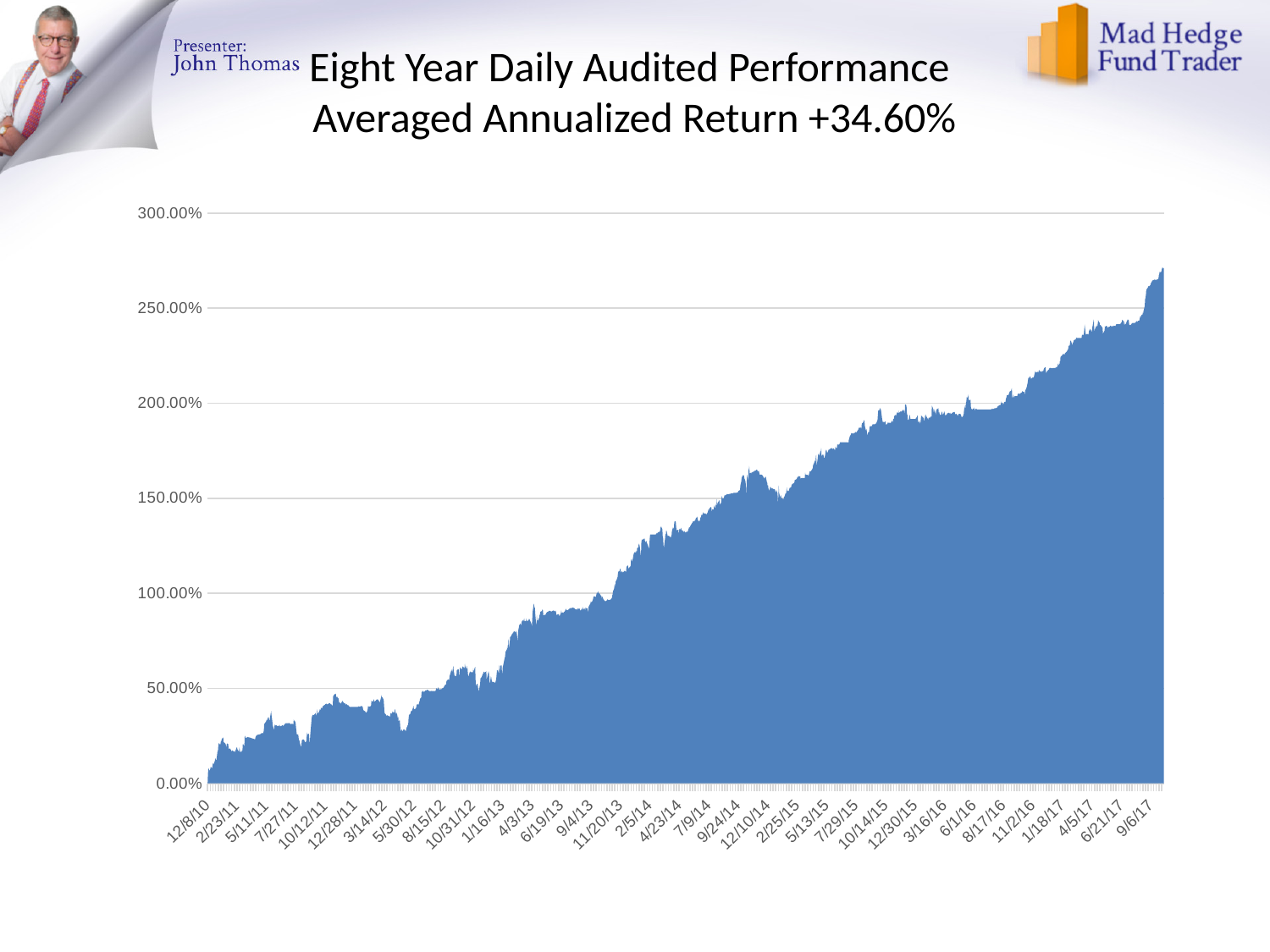
Is the value at 2/5/14 greater or less than 100.00%? greater Is the value at 9/6/17 greater or less than 250.00%? greater What kind of chart is shown on the slide? Area chart What is the averaged annualized return stated in the chart title? +34.60% How many date labels are shown on the x axis? 33 What is the highest value shown on the y axis? 300.00% Is the value at 4/3/13 greater or less than 50.00%? greater Which is larger, the value at 9/4/13 or the value at 9/24/14? 9/24/14 Do the values generally rise or fall from 12/8/10 to 9/6/17? Rise